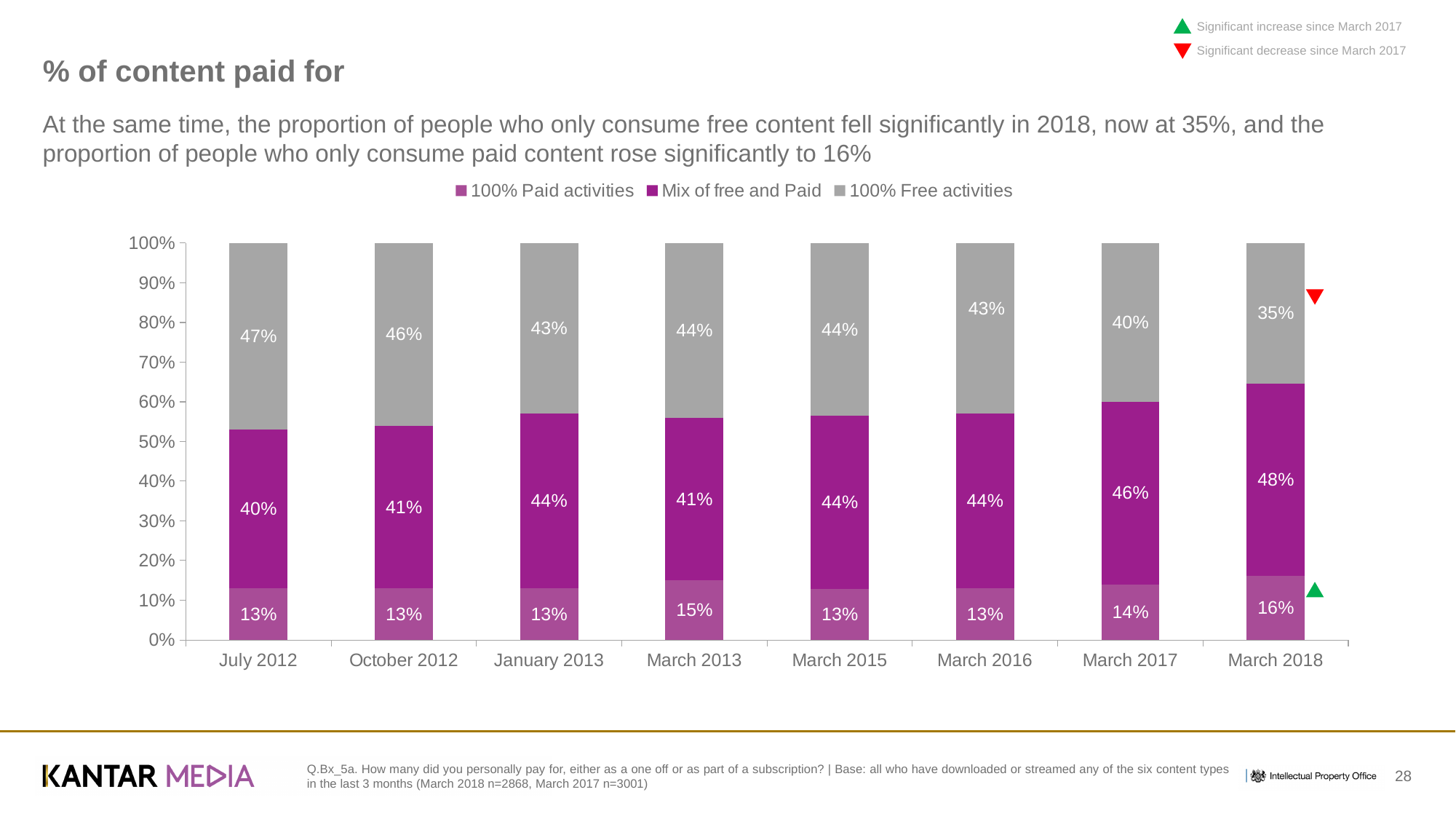
What is the value for 100% Free activities in March 2018? 35% What is the title of the chart? % of content paid for What is the value for 100% Paid activities in March 2013? 15% How many series does the legend list? 3 What is the value for Mix of free and Paid in March 2017? 46% Does the 100% Free activities value rise or fall from March 2016 to March 2018? Fall In which period is the 100% Free activities value highest? July 2012 What kind of chart is shown on the slide? Stacked bar chart Which is larger in March 2018: the Mix of free and Paid value or the 100% Free activities value? Mix of free and Paid What is the difference between the 100% Free activities values for March 2017 and March 2018? 5% In which period is the Mix of free and Paid value lowest? July 2012 How many time periods are shown on the x axis? 8